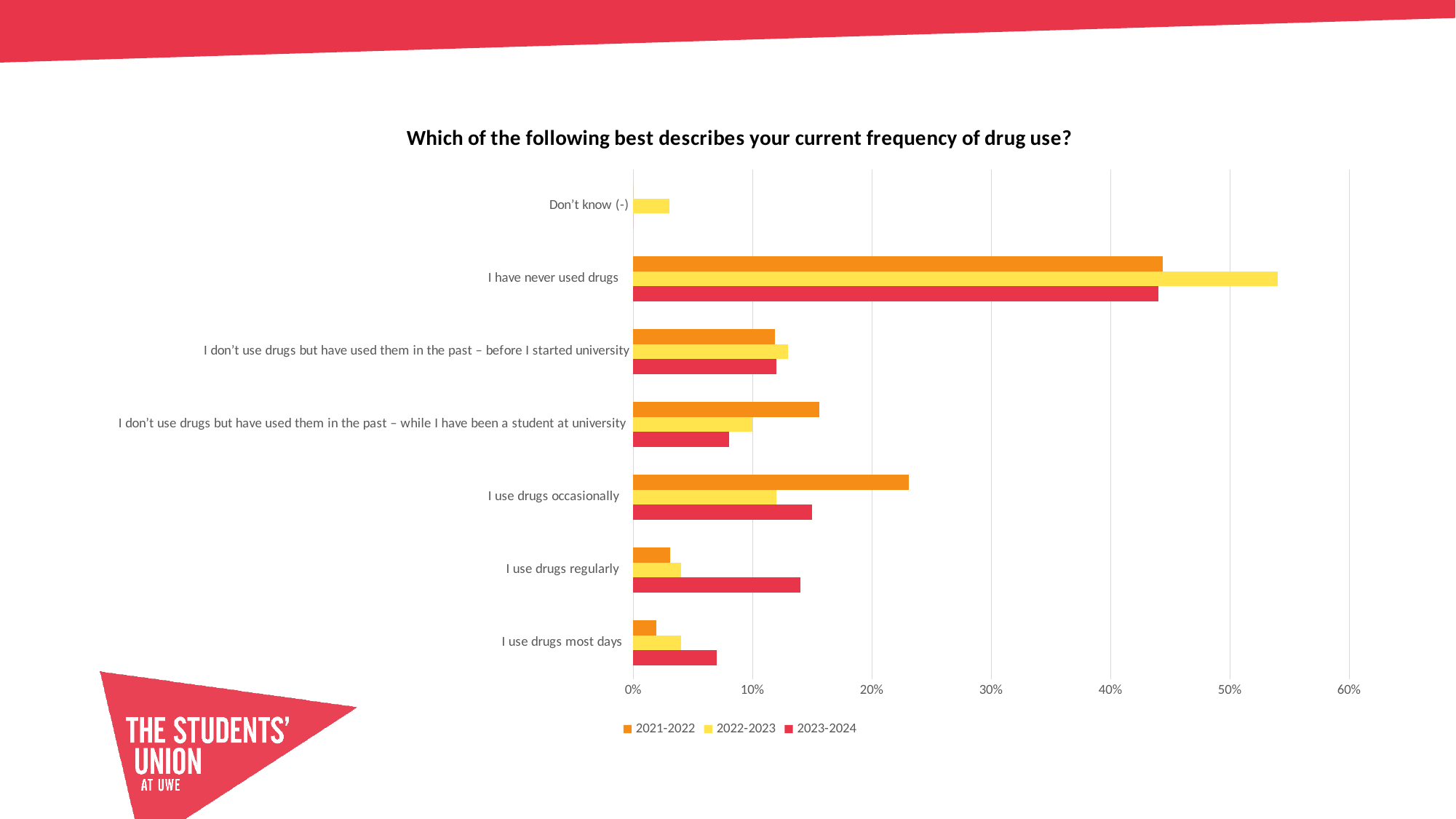
Is the 2023-2024 value for "I use drugs regularly" greater or less than 10%? greater For "I use drugs regularly", which series has the larger value: 2021-2022 or 2023-2024? 2023-2024 What kind of chart is shown on the slide? Bar chart Is the 2023-2024 value for "I use drugs most days" greater or less than 10%? less Which series is shown in yellow in the legend? 2022-2023 Which category has the highest value for the 2022-2023 series? I have never used drugs Is the 2022-2023 value for "I have never used drugs" greater or less than 50%? greater How many categories are shown on the chart? 7 For "I use drugs occasionally", which series has the larger value: 2021-2022 or 2023-2024? 2021-2022 How many series does the legend list? 3 What is the title of the chart? Which of the following best describes your current frequency of drug use?